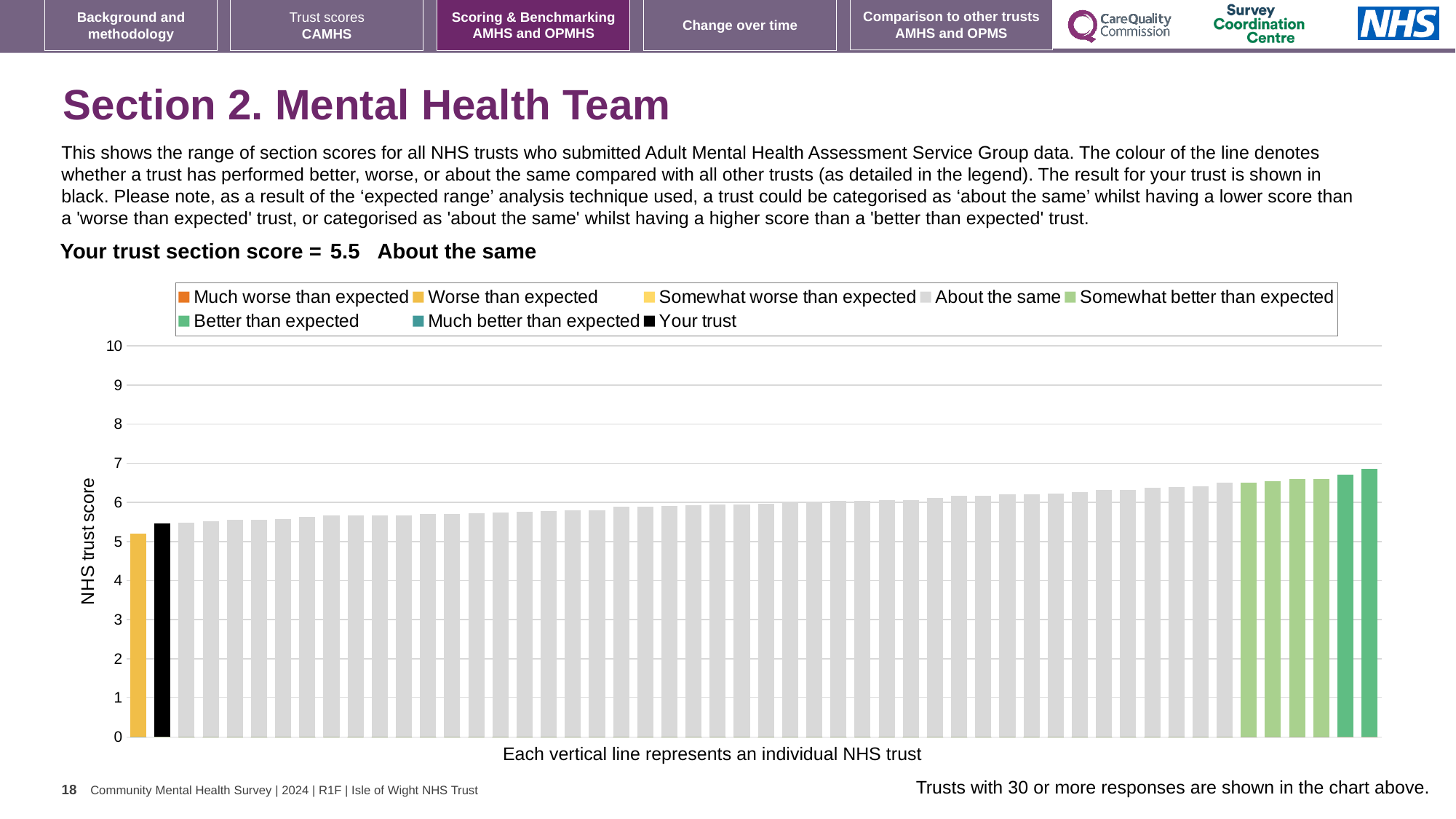
How many bars on the chart are coloured yellow (worse than expected)? 1 Do the bar values rise or fall from left to right across the chart? rise Is the value of the tallest bar on the chart greater or less than 6? greater How many entries does the chart legend list? 8 Which is larger: the black bar for your trust or the yellow 'Worse than expected' bar? the black bar for your trust What kind of chart is shown on the slide? bar chart Is the value for your trust (the black bar) greater or less than 5? greater What is the label on the vertical axis of the chart? NHS trust score Is the value for your trust (the black bar) greater or less than 6? less What colour is used for the bar representing your trust? black What is the section score for your trust shown on the chart? 5.5